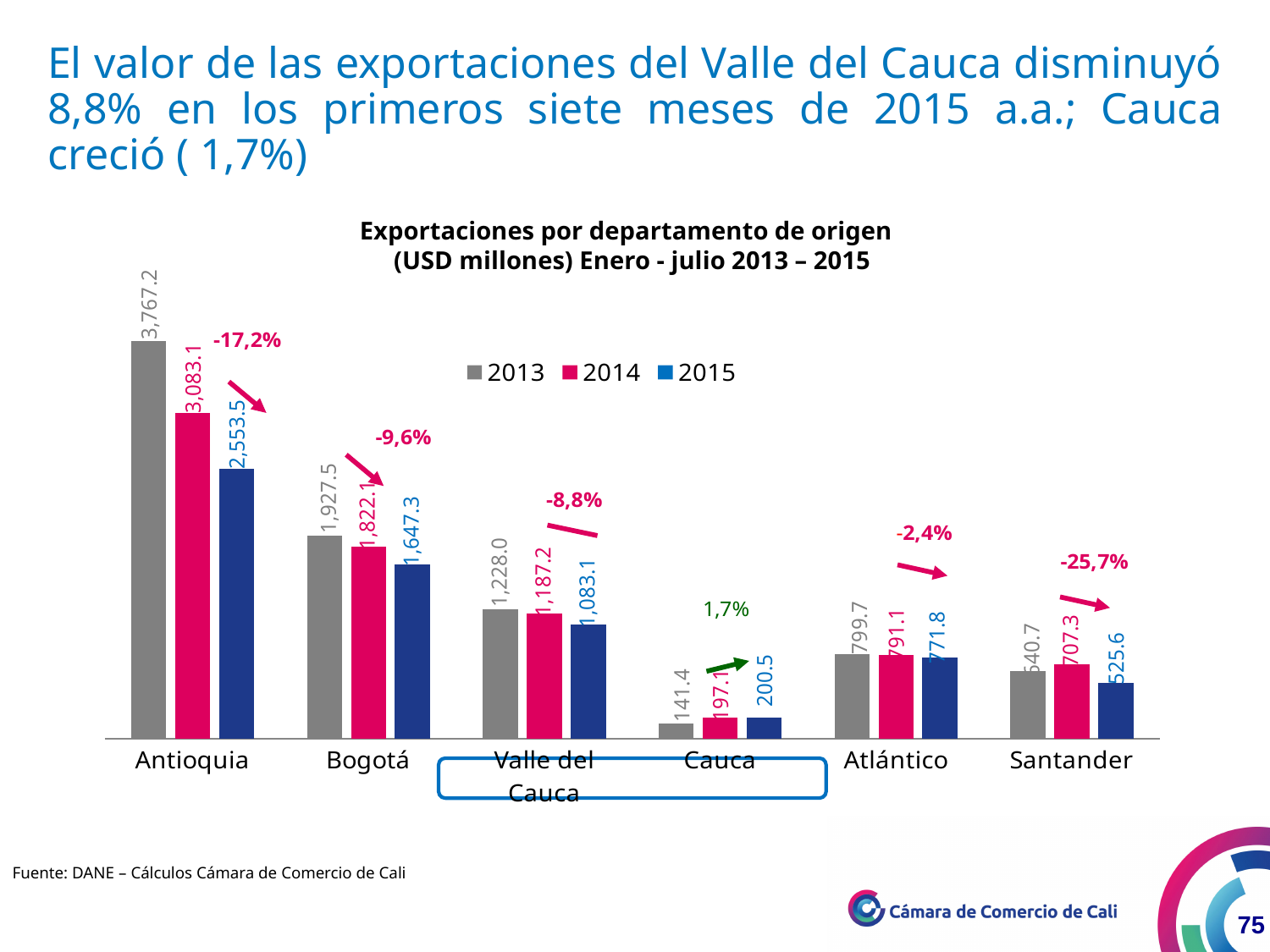
Do the values for Valle del Cauca rise or fall from 2013 to 2015? Fall How many series does the legend list? 3 What is the difference between the 2013 and 2014 values for Antioquia? 684.1 What is the value for Cauca in 2013? 141.4 Which department has the lowest value in 2015? Cauca Which is larger in 2015: Bogotá or Valle del Cauca? Bogotá What is the difference between the 2015 and 2014 values for Cauca? 3.4 What kind of chart is shown on the slide? Bar chart Which department has the highest value in 2013? Antioquia How many departments are shown on the x axis? 6 What is the value for Antioquia in 2015? 2,553.5 What is the value for Atlántico in 2014? 791.1